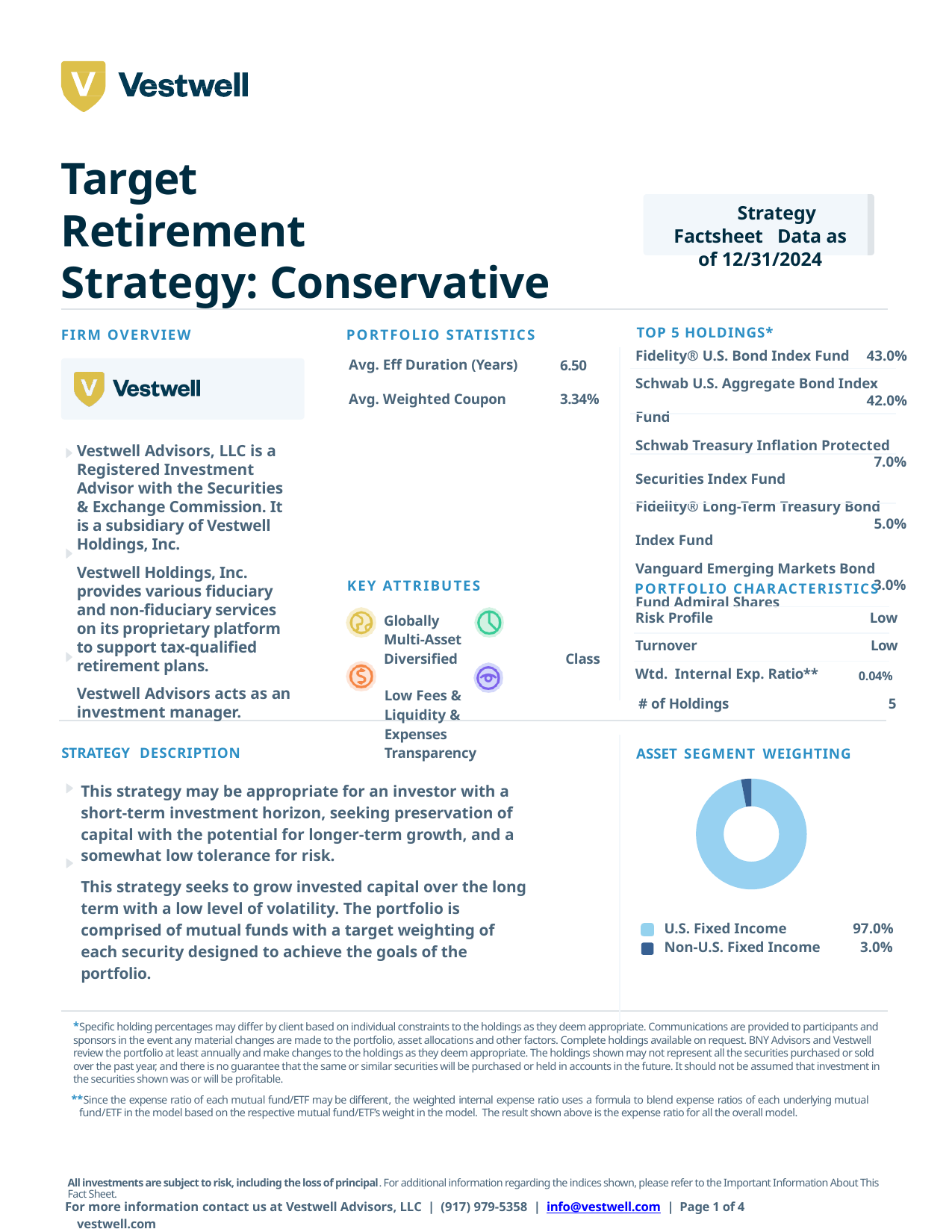
How many segments does the Asset Segment Weighting chart have? 2 What kind of chart is shown under Asset Segment Weighting? Pie chart (donut) In the Asset Segment Weighting chart, which is larger: U.S. Fixed Income or Non-U.S. Fixed Income? U.S. Fixed Income Which segment is the largest in the Asset Segment Weighting chart? U.S. Fixed Income Which segment is the smallest in the Asset Segment Weighting chart? Non-U.S. Fixed Income In the Asset Segment Weighting chart, what is the difference between U.S. Fixed Income and Non-U.S. Fixed Income? 94.0% How many entries does the legend of the Asset Segment Weighting chart list? 2 What share of the Asset Segment Weighting chart does Non-U.S. Fixed Income represent? 3.0% What is the title of the section containing the donut chart? Asset Segment Weighting In the Asset Segment Weighting chart, which segment is shown in dark blue? Non-U.S. Fixed Income In the Asset Segment Weighting chart, what is the value for U.S. Fixed Income? 97.0% In the Asset Segment Weighting chart, what is the value for Non-U.S. Fixed Income? 3.0%